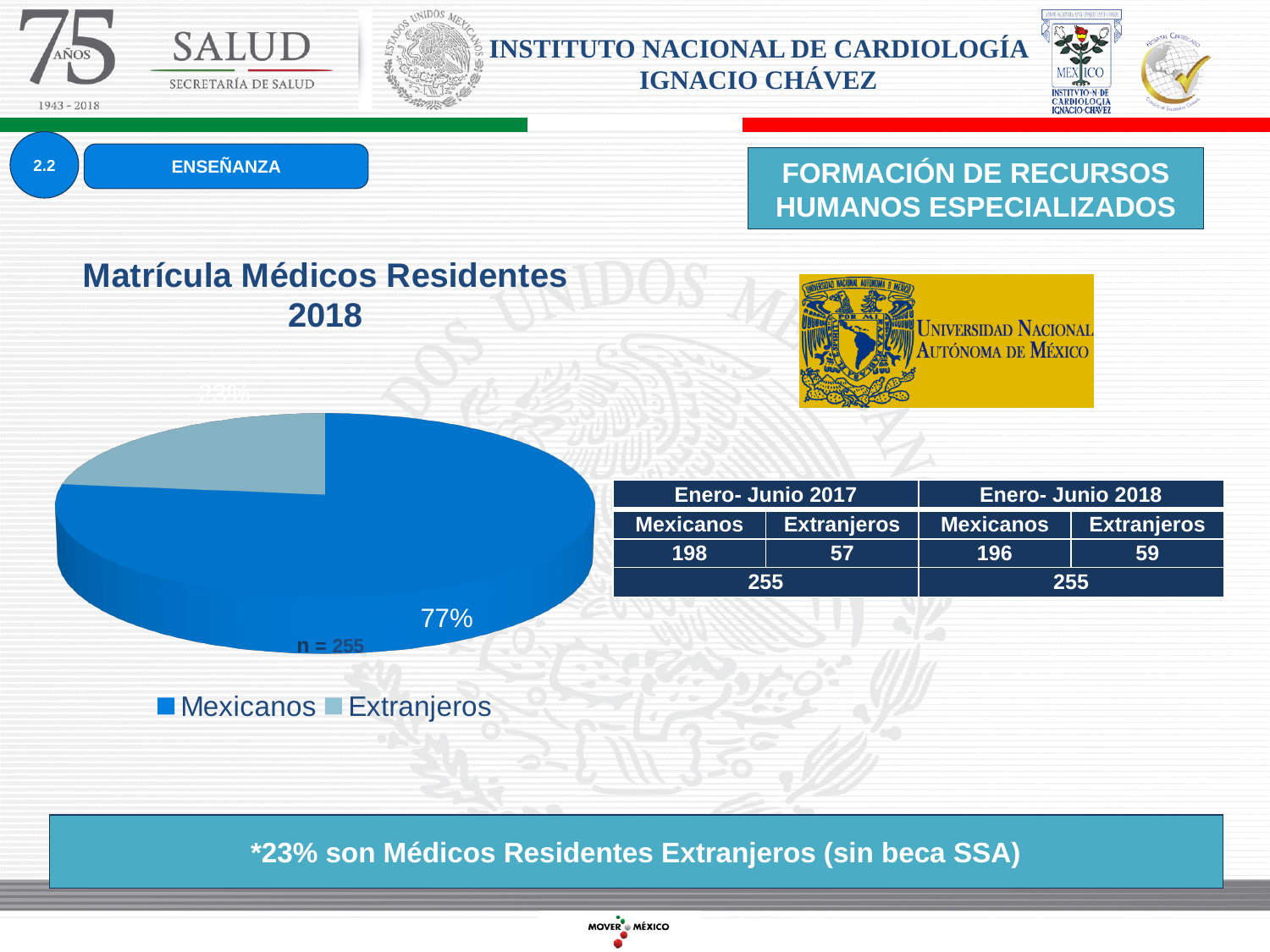
How many slices does the pie chart have? 2 What kind of chart is shown under the title "Matrícula Médicos Residentes 2018"? pie chart Which category has the largest slice in the pie chart? Mexicanos What is the value of n shown below the pie chart? n = 255 Which slice is larger in the pie chart, Mexicanos or Extranjeros? Mexicanos Is the Extranjeros share of the pie chart greater or less than 50%? less What share of the pie chart does the Mexicanos slice represent? 77% What is the title of the pie chart? Matrícula Médicos Residentes 2018 What is the difference in percentage points between the Mexicanos and Extranjeros slices of the pie chart? 54 Which category has the smallest slice in the pie chart? Extranjeros What share of the pie chart does the Extranjeros slice represent? 23% How many entries does the legend of the pie chart list? 2